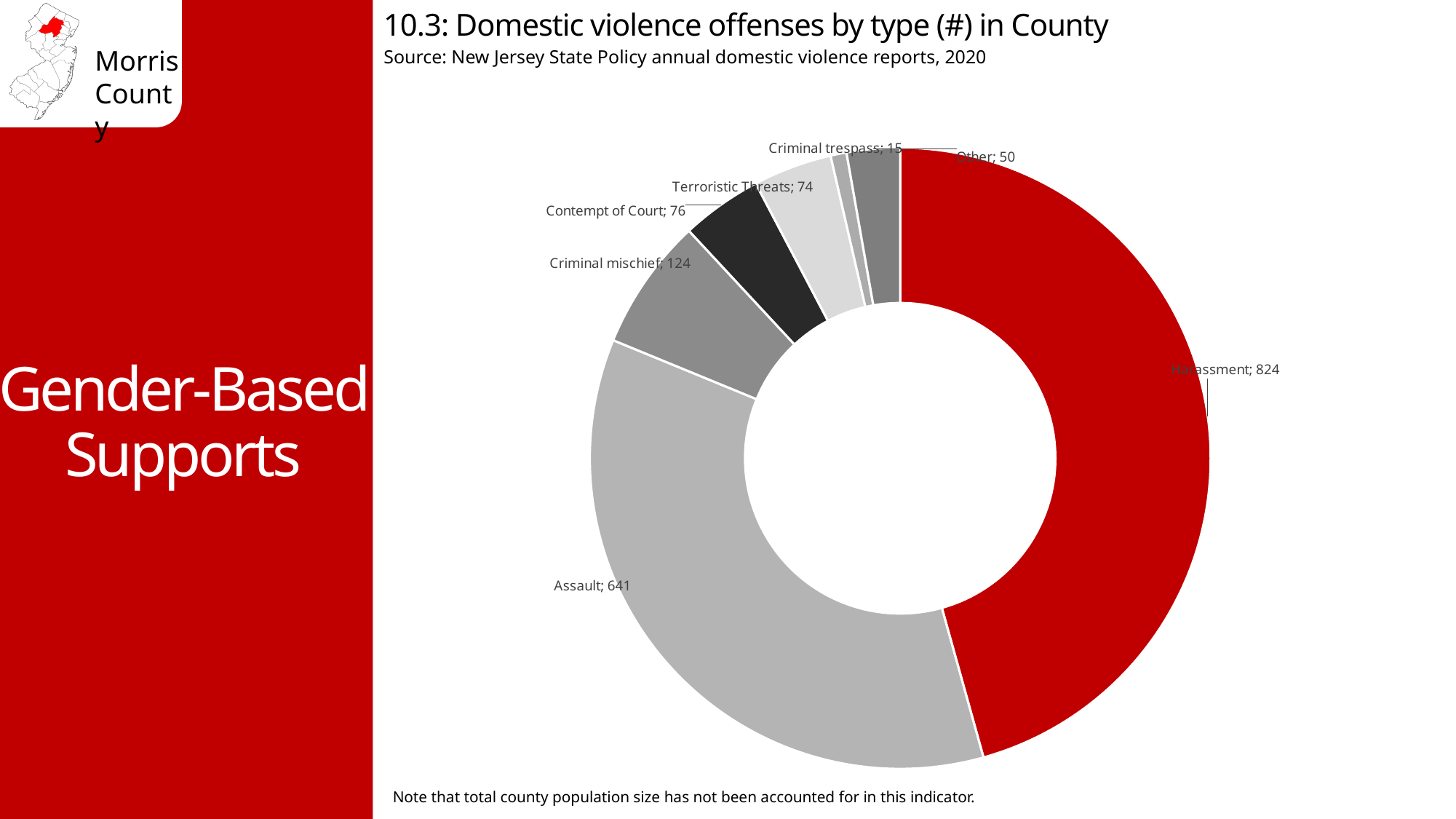
What is the value for Terroristic Threats? 74 What is the value for Contempt of Court? 76 Which offense type has the highest number on the chart? Harassment What is the title of the chart? 10.3: Domestic violence offenses by type (#) in County What is the difference between the Harassment and Assault values? 183 What is the value for Criminal trespass? 15 How many domestic violence offenses of type Harassment are shown on the chart? 824 Which is larger, Contempt of Court or Terroristic Threats? Contempt of Court What kind of chart is shown on the slide? doughnut chart What is the value for Criminal mischief? 124 What is the value for Assault on the chart? 641 What is the value for the Other category? 50